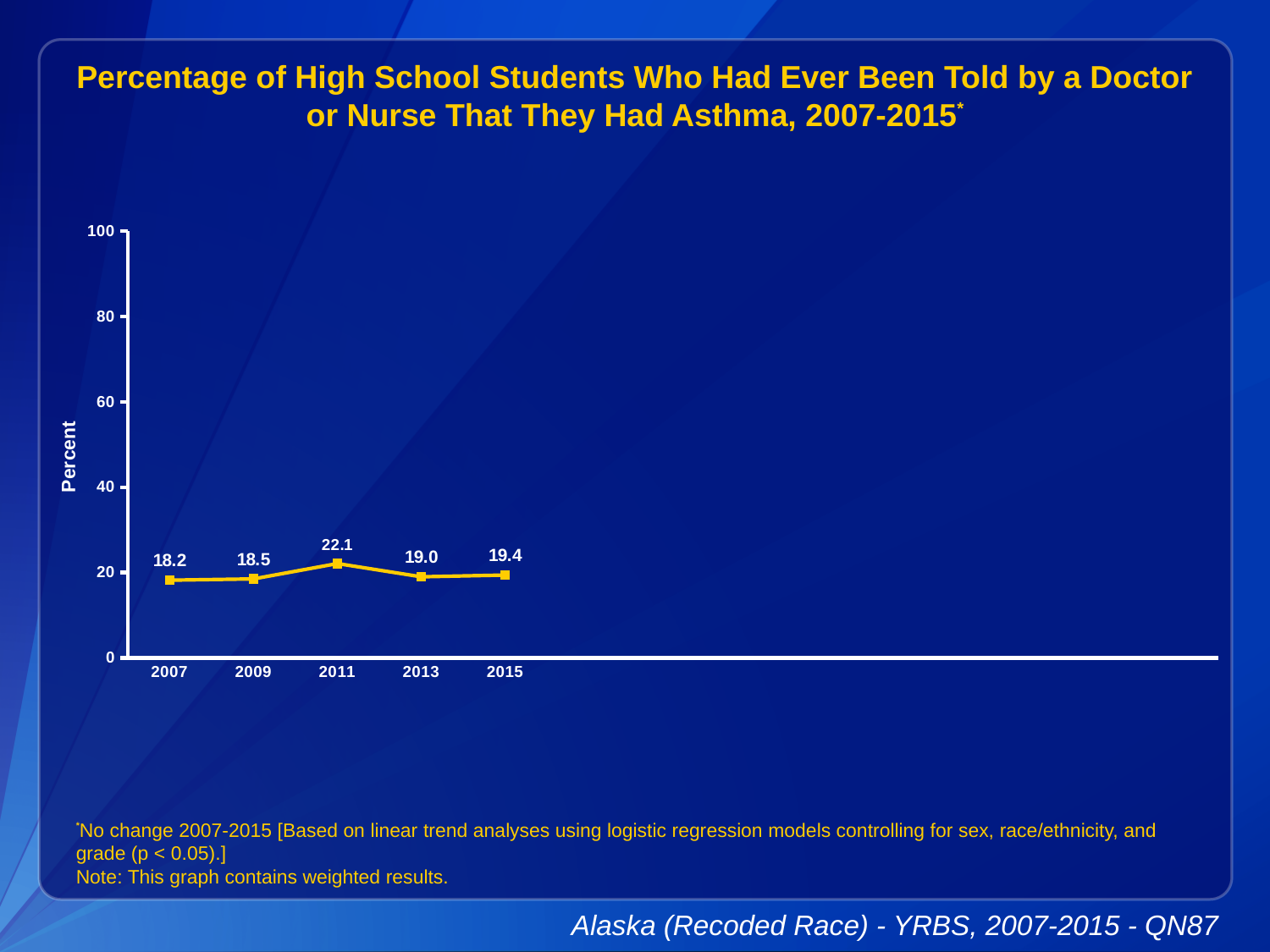
What kind of chart is shown? line chart What is the value for 2007? 18.2 How many years are plotted on the chart? 5 Which is larger, the value for 2009 or the value for 2015? 2015 What is the difference between the values for 2015 and 2007? 1.2 Which year has the highest value? 2011 What is the label on the y axis? Percent What is the value for 2011? 22.1 Which year has the lowest value? 2007 What is the difference between the values for 2011 and 2013? 3.1 What is the value for 2015? 19.4 Is the value for 2011 greater or less than 20? greater